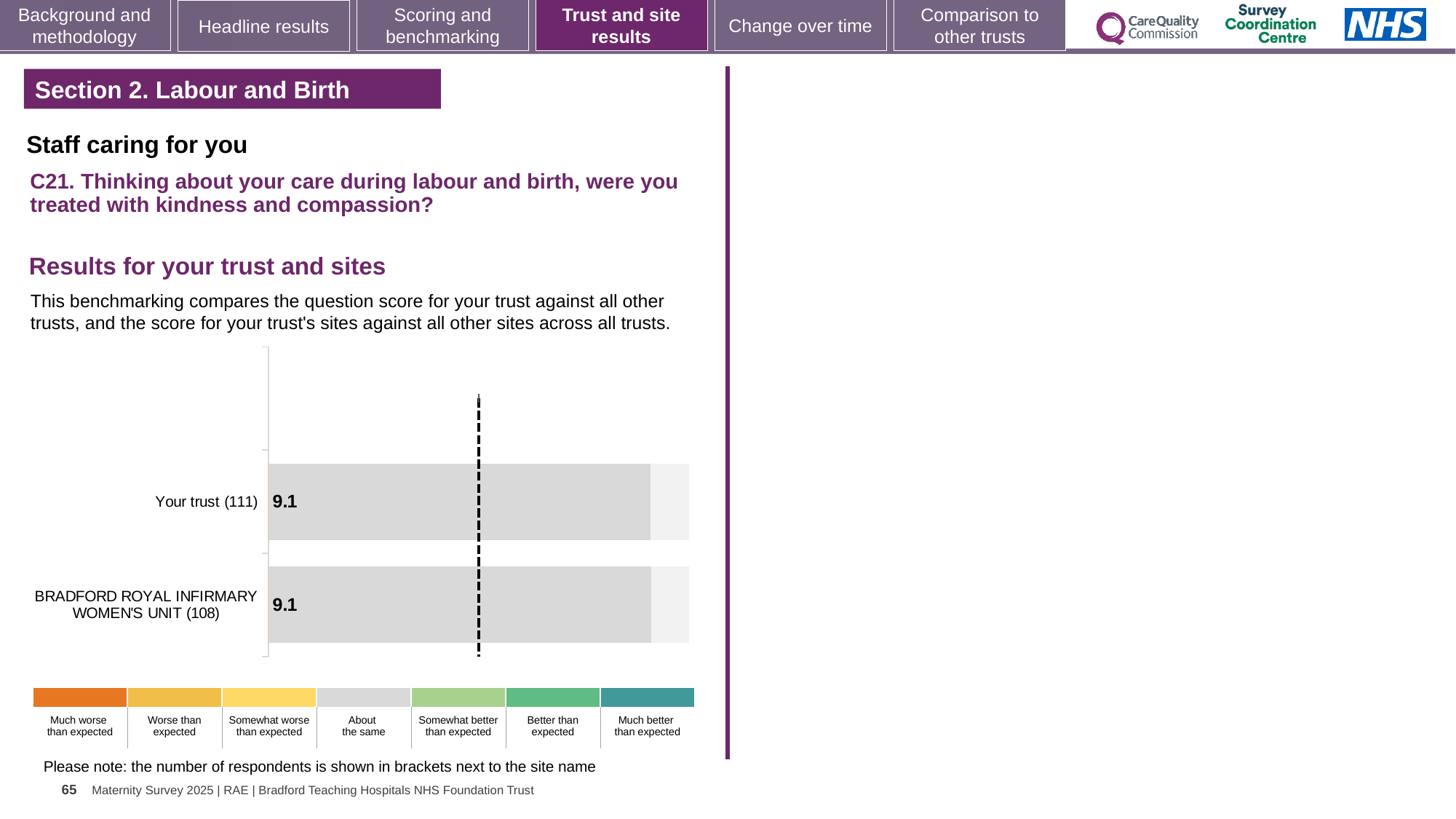
What is the score for BRADFORD ROYAL INFIRMARY WOMEN'S UNIT (108) on the chart? 9.1 What kind of chart is shown on the slide? Bar chart What is the difference between the score for Your trust and the score for BRADFORD ROYAL INFIRMARY WOMEN'S UNIT? 0 What is the score for Your trust (111) on the chart? 9.1 How many benchmarking categories does the colour key below the chart list? 7 How many respondents are shown in brackets for Your trust? 111 How many bars are plotted on the chart? 2 How many respondents are shown in brackets for BRADFORD ROYAL INFIRMARY WOMEN'S UNIT? 108 Is the score for Your trust the same as the score for BRADFORD ROYAL INFIRMARY WOMEN'S UNIT? Yes, both are 9.1 Which benchmarking category does the grey colour of the bars correspond to in the key? About the same